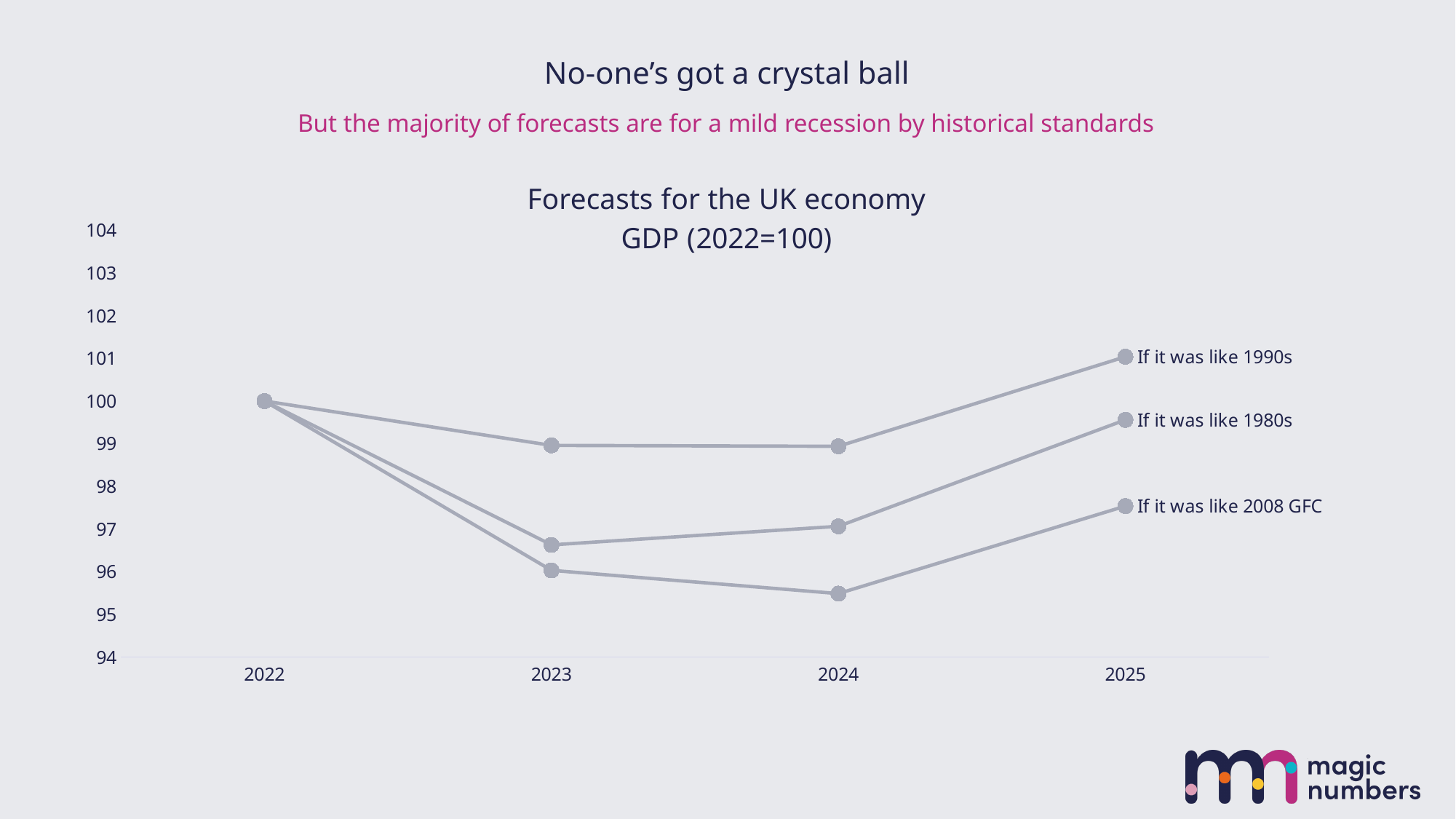
Which scenario has the lowest GDP index value in 2024? If it was like 2008 GFC Does the 'If it was like 2008 GFC' line rise or fall between 2024 and 2025? rise Which is larger in 2025: the value for 'If it was like 1980s' or 'If it was like 2008 GFC'? If it was like 1980s Which scenario has the highest GDP index value in 2025? If it was like 1990s What kind of chart is shown on the slide? line chart How many series (scenario lines) are plotted on the chart? 3 Is the 2023 value for the 'If it was like 1980s' scenario greater or less than 97? less What is the title of the chart? Forecasts for the UK economy GDP (2022=100) How many years are shown along the x axis of the chart? 4 What is the GDP index value for all three scenarios in 2022? 100 Is the 2025 value for the 'If it was like 1980s' scenario greater or less than 99? greater Is the 2024 value for the 'If it was like 2008 GFC' scenario greater or less than 96? less